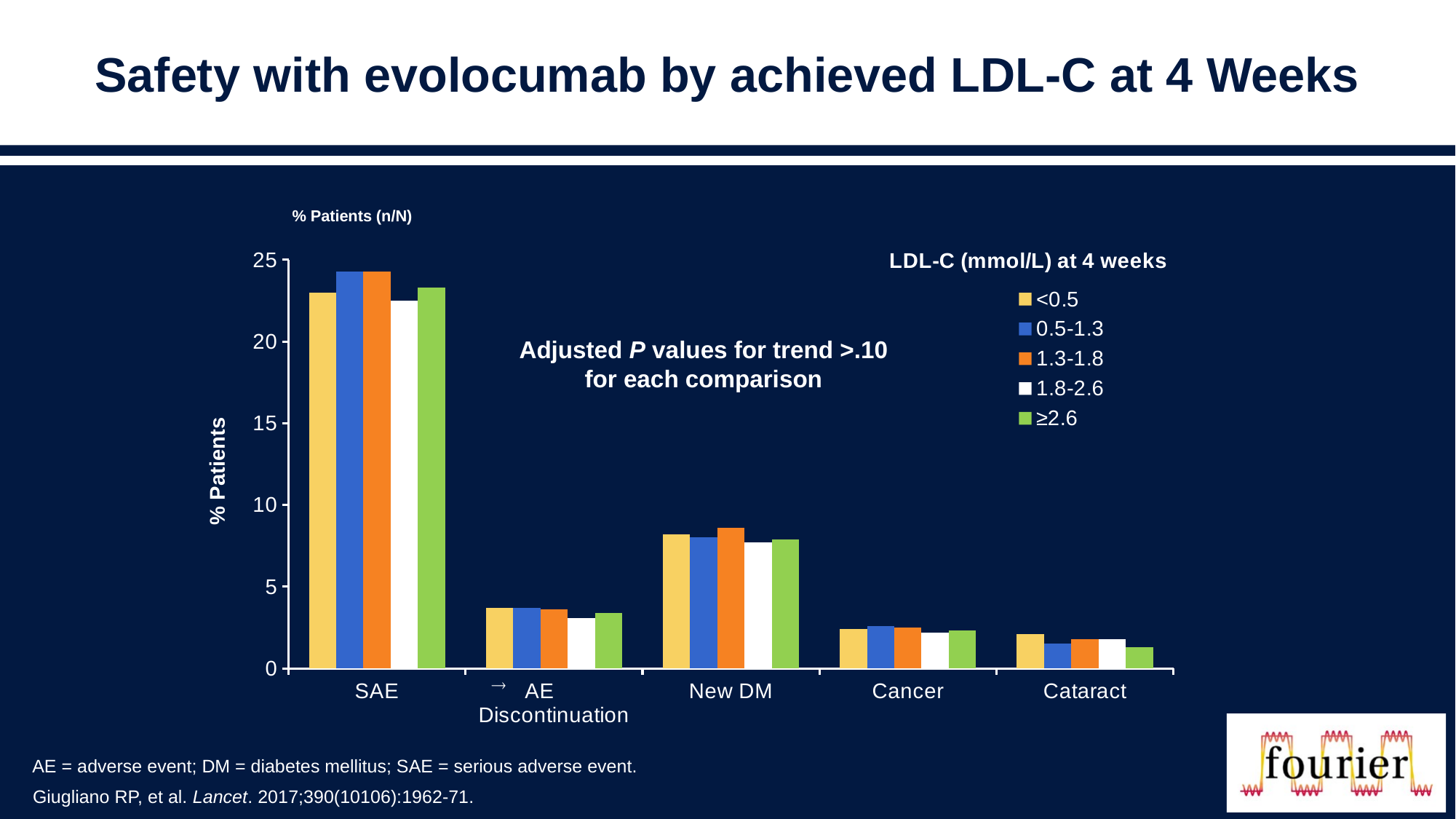
How many categories are shown along the x axis of the chart? 5 What is the title of the chart's legend? LDL-C (mmol/L) at 4 weeks Is the value for New DM in the 1.3-1.8 series greater or less than 10? less For the ≥2.6 series, which category has the lowest value? Cataract What kind of chart is shown on the slide? bar chart Is the value for Cancer in the 0.5-1.3 series greater or less than 5? less Is the value for SAE in the <0.5 series greater or less than 20? greater For the <0.5 series, which is larger: SAE or New DM? SAE How many series does the chart's legend list? 5 Which category has the tallest bars in the chart? SAE For the ≥2.6 series, which is larger: Cancer or Cataract? Cancer